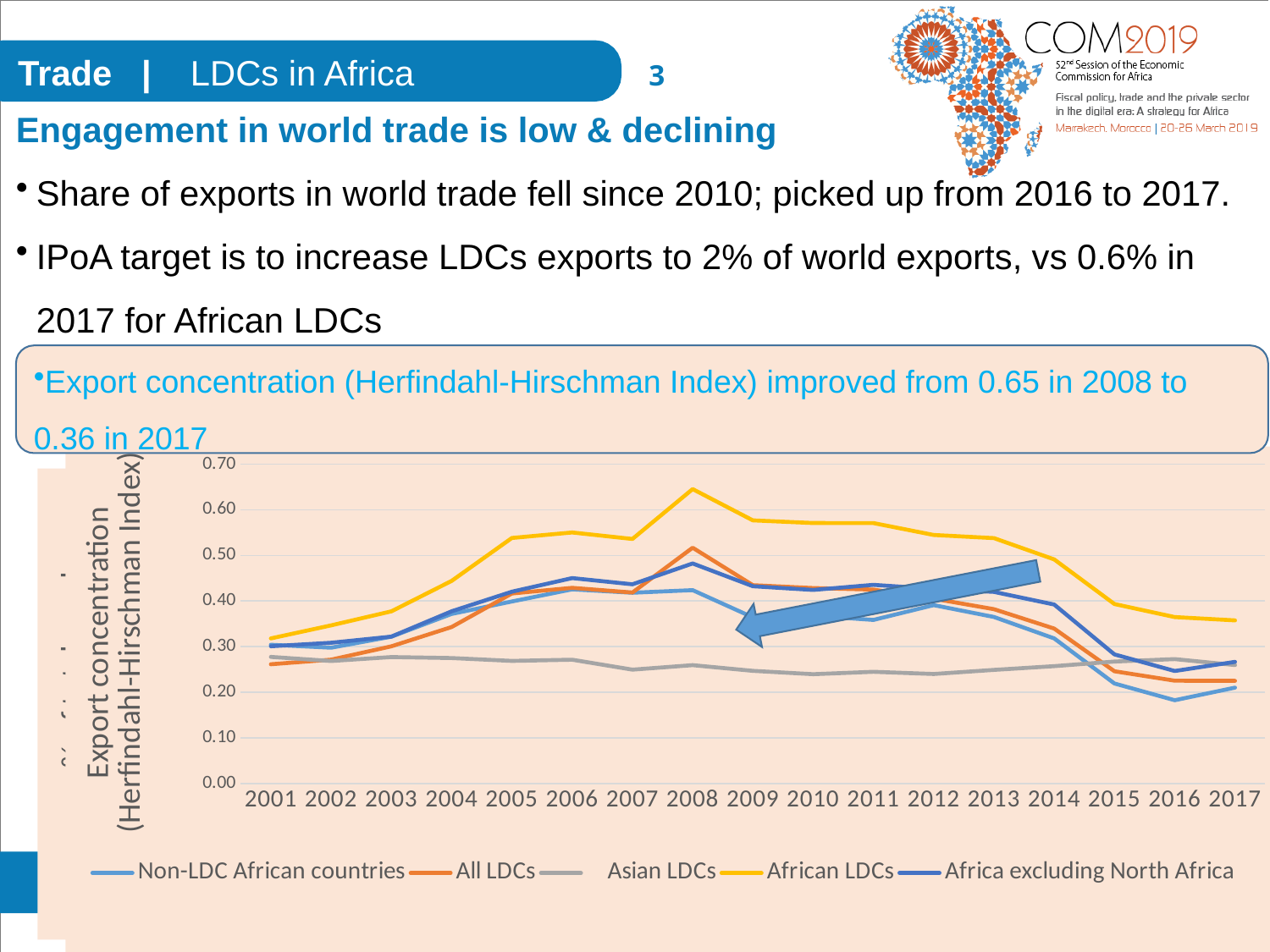
Does the African LDCs line rise or fall from 2008 to 2017? fall Is the value for Asian LDCs in 2010 greater or less than 0.30? less How many years are shown along the x axis of the chart? 17 How many series does the chart's legend list? 5 What is the label on the chart's y axis? Export concentration (Herfindahl-Hirschman Index) In 2010, which is larger: the value for African LDCs or the value for Asian LDCs? African LDCs Which series has the lowest value in 2016? Non-LDC African countries Which series has the highest value in 2008? African LDCs Which colour is used for the African LDCs line in the chart? yellow What kind of chart is shown on the slide? line chart Is the value for African LDCs in 2008 greater or less than 0.60? greater Is the value for Non-LDC African countries in 2016 greater or less than 0.30? less